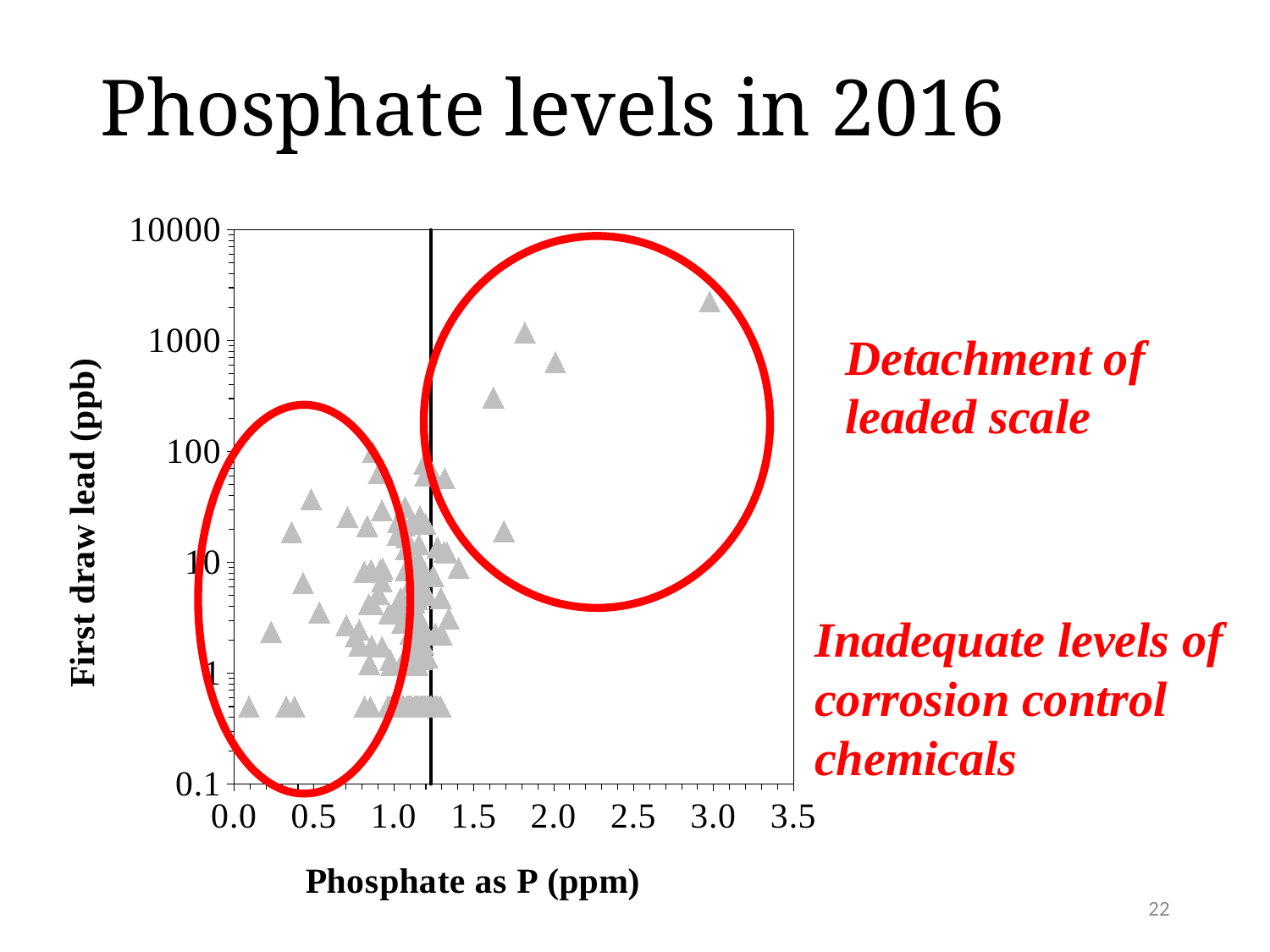
What kind of chart is shown on the slide? Scatter plot Is the first draw lead value of the lowest points on the chart greater or less than 1? less What is the title of the slide's chart? Phosphate levels in 2016 What is the label of the x axis? Phosphate as P (ppm) What is the maximum value shown on the x axis? 3.5 Is the first draw lead value of the highest point on the chart greater or less than 1000? greater Is the phosphate value of the leftmost point on the chart greater or less than 0.5? less What is the maximum value shown on the y axis? 10000 Which point has the higher first draw lead value: the one at about 3.0 ppm phosphate or the one at about 1.6 ppm phosphate? The one at about 3.0 ppm